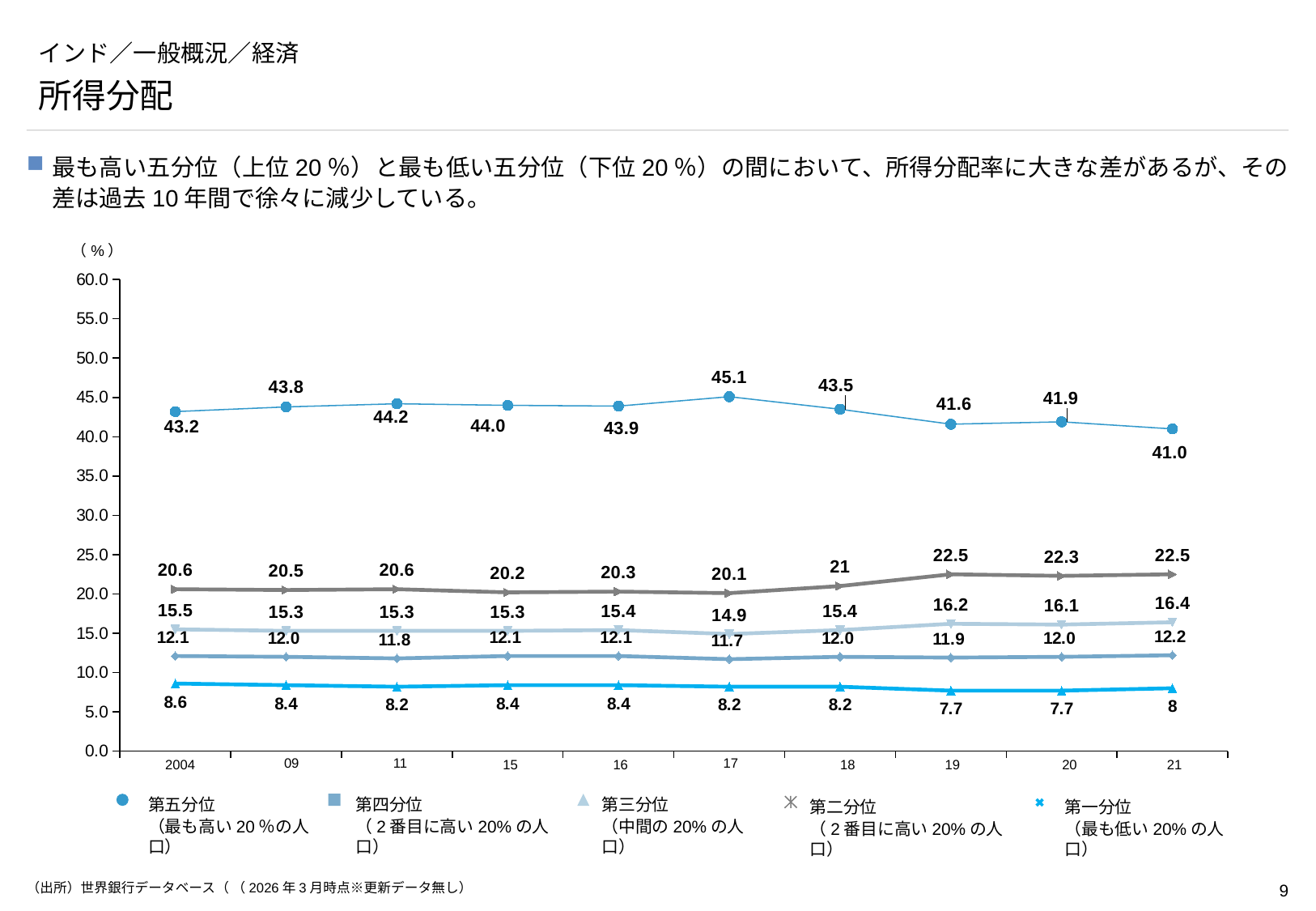
What is the value of the lowest line (第一分位, 最も低い 20%) in 19? 7.7 Which is larger for 第五分位: the value in 2017 or the value in 2004? 2017 In which year is the 第五分位 line at its lowest? 21 How many years are shown on the x axis? 10 What is the value of the lowest line (第一分位, 最も低い 20%) in 2004? 8.6 What is the value for 第五分位 in 21? 41.0 What is the difference between the 第五分位 value in 2004 and in 21? 2.2 In which year is the 第五分位 line at its highest? 17 Does the 第五分位 line rise or fall from 17 to 21? fall What is the value for 第五分位 in 2017? 45.1 How many series does the legend list? 5 What kind of chart is shown on the slide? line chart